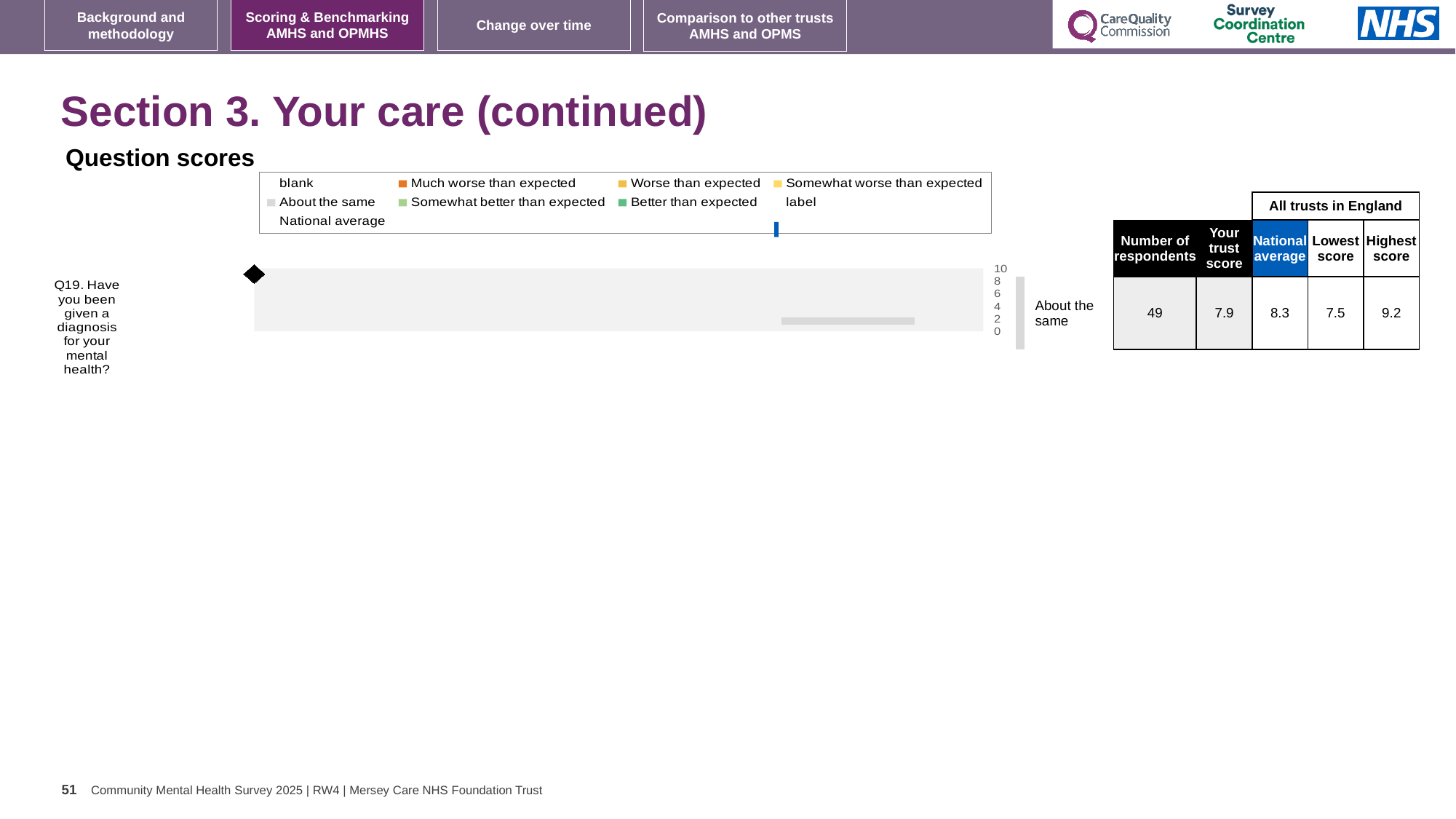
What is the lowest score among all trusts in England for Q19? 7.5 Which question is plotted in the Question scores chart? Q19. Have you been given a diagnosis for your mental health? How many respondents answered Q19? 49 How many questions are plotted in the Question scores chart? 1 Which is larger for Q19, the trust score or the national average? national average What kind of chart is shown under 'Question scores'? bar chart What is the highest score among all trusts in England for Q19? 9.2 What is the national average score for Q19? 8.3 Is the trust score for Q19 greater or less than 6 on the chart's axis? greater What benchmark category is shown for Q19 in the Question scores chart? About the same What is the difference between the highest and lowest scores for Q19 across all trusts in England? 1.7 What is the trust score for Q19? 7.9